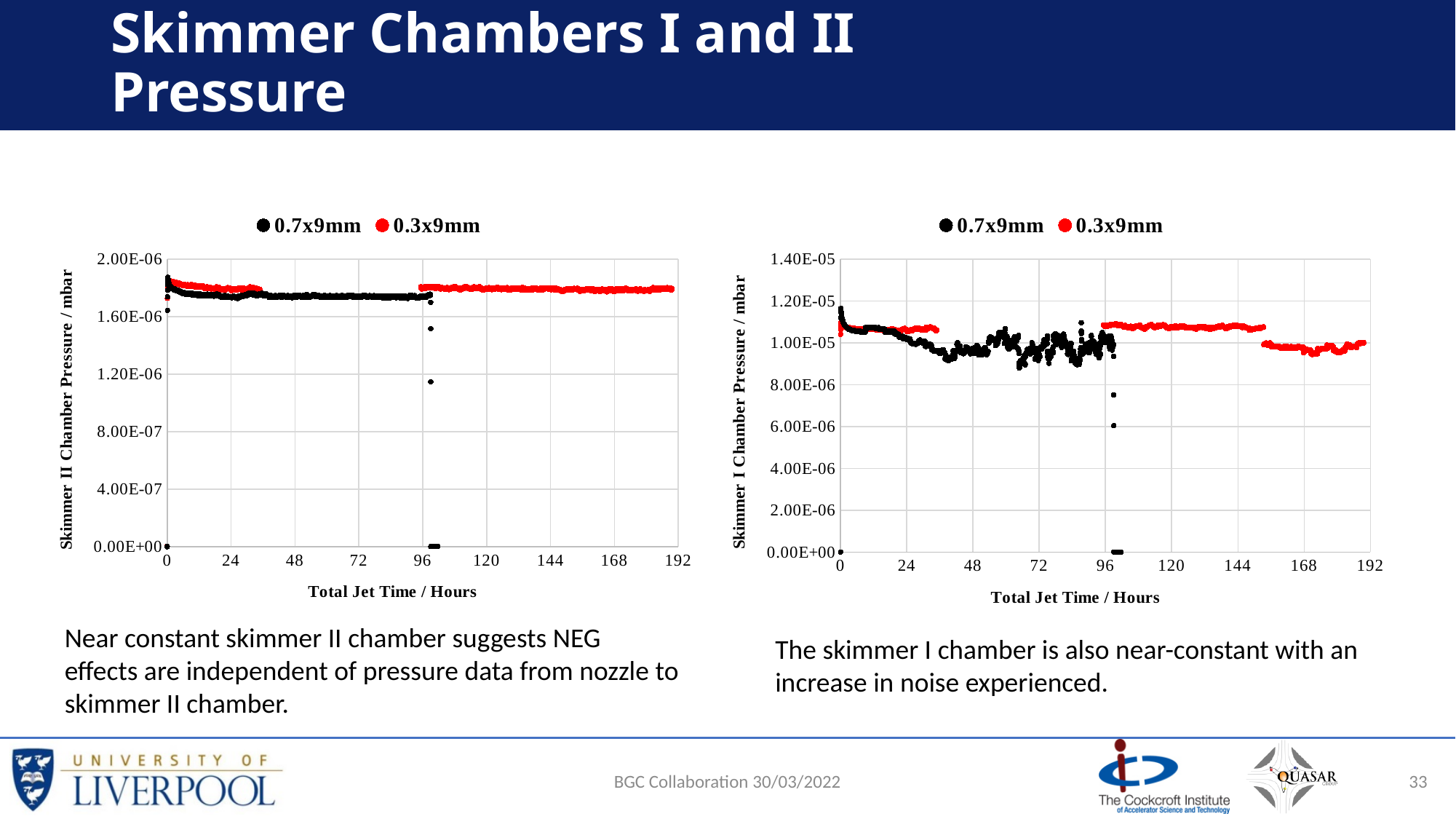
In the right chart (Skimmer I Chamber Pressure), which is larger for the 0.3x9mm series: the value at 120 hours or the value at 168 hours? 120 hours How many series does the legend of the right chart (Skimmer I Chamber Pressure) list? 2 What is the x-axis label of the left chart (Skimmer II Chamber Pressure)? Total Jet Time / Hours What kind of chart is the left chart (Skimmer II Chamber Pressure)? scatter chart In the left chart (Skimmer II Chamber Pressure), is the value of the 0.3x9mm series at 144 hours greater or less than 2.00E-06? less What is the highest y-axis tick value shown on the right chart (Skimmer I Chamber Pressure)? 1.40E-05 In the right chart (Skimmer I Chamber Pressure), is the value of the 0.3x9mm series at 120 hours greater or less than 1.00E-05? greater In the right chart (Skimmer I Chamber Pressure), is the value of the 0.7x9mm series at 48 hours greater or less than 8.00E-06? greater What colour are the 0.3x9mm points in the right chart (Skimmer I Chamber Pressure)? red